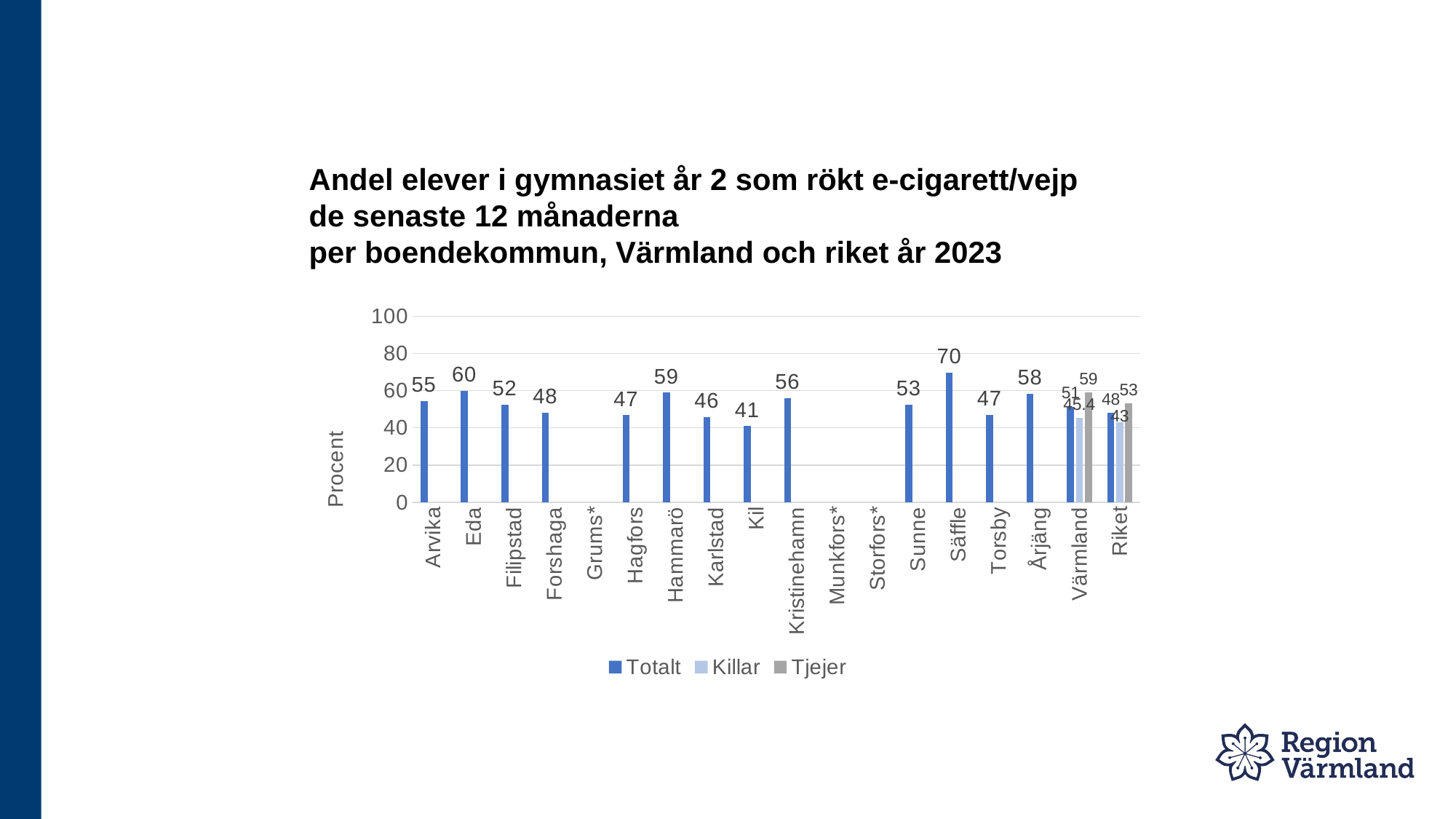
Is the Totalt value for Kil greater or less than 60? less What kind of chart is shown on the slide? bar chart Which has a higher Totalt value, Kristinehamn or Karlstad? Kristinehamn How many categories are listed on the x axis? 18 What is the label on the y axis? Procent How many series does the legend list? 3 Which category has the lowest Totalt value among those with a plotted bar? Kil What is the Killar value for Värmland? 45.4 Which category has the highest Totalt value? Säffle What is the Tjejer value for Riket? 53 What is the difference between the Totalt values for Eda and Arvika? 5 What is the Totalt value for Säffle? 70